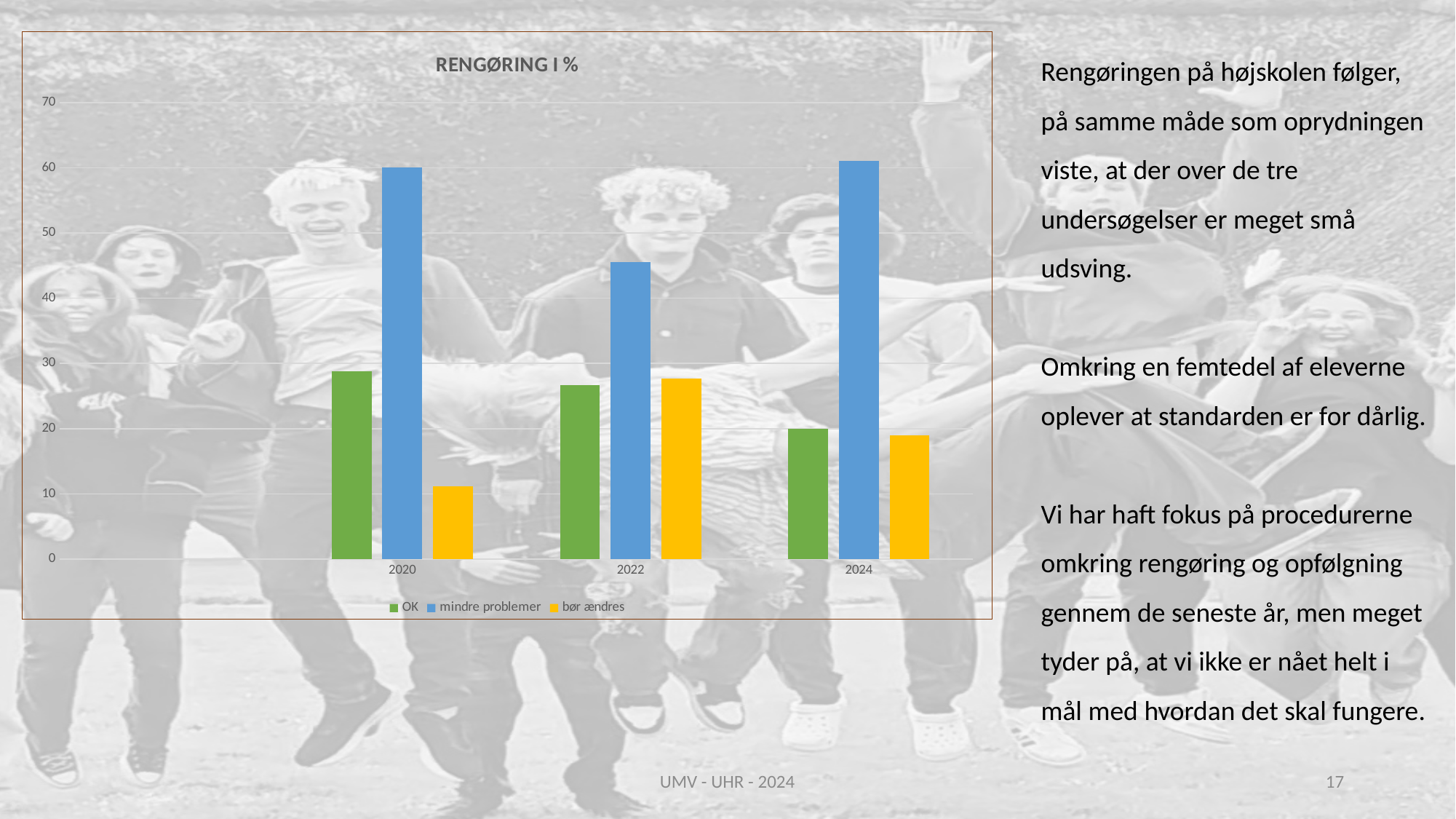
What is the title of the chart? RENGØRING I % Does the 'OK' series rise or fall from 2020 to 2024? fall What is the value for 'mindre problemer' in 2020? 60 In 2020, which series has the highest value? mindre problemer Which is larger: the 'OK' value in 2020 or the 'OK' value in 2024? 2020 What kind of chart is shown on the slide? bar chart Is the value for 'mindre problemer' in 2022 greater or less than 50? less Is the value for 'OK' in 2020 greater or less than 20? greater In 2020, which series has the lowest value? bør ændres How many series does the legend list? 3 Which series is shown in blue? mindre problemer How many years are shown on the x axis? 3